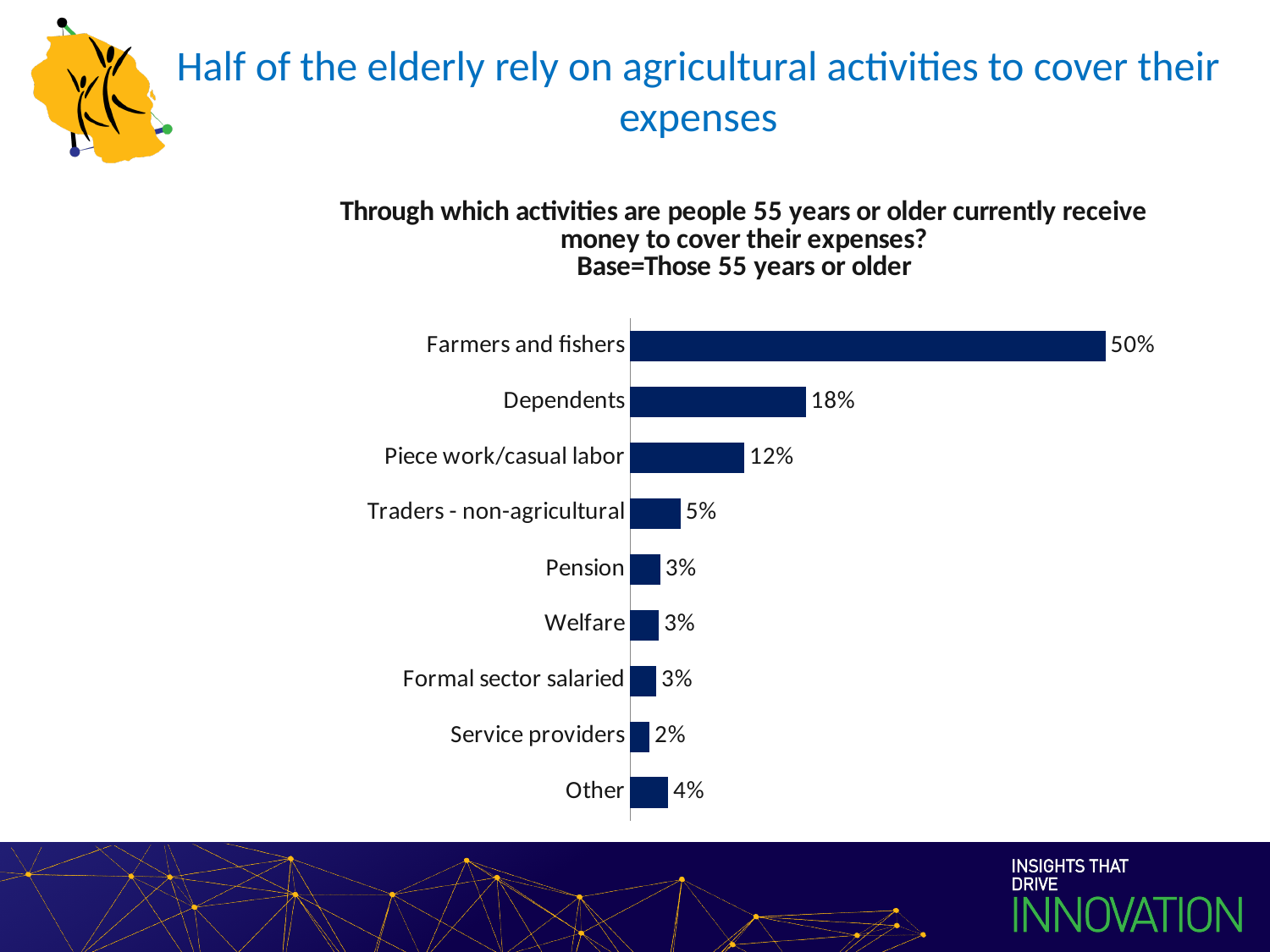
How many categories are shown in the chart? 9 What is the base population stated in the chart title? Those 55 years or older What is the difference between the values for Farmers and fishers and Dependents? 32% What is the value for Piece work/casual labor? 12% What is the value for Service providers? 2% What kind of chart is shown on the slide? Bar chart Which category has the lowest value? Service providers What is the value for Dependents? 18% Which is larger, the value for Other or the value for Welfare? Other Which category has the highest value? Farmers and fishers What is the difference between the values for Traders - non-agricultural and Pension? 2% What percentage of people 55 years or older receive money through farming and fishing? 50%